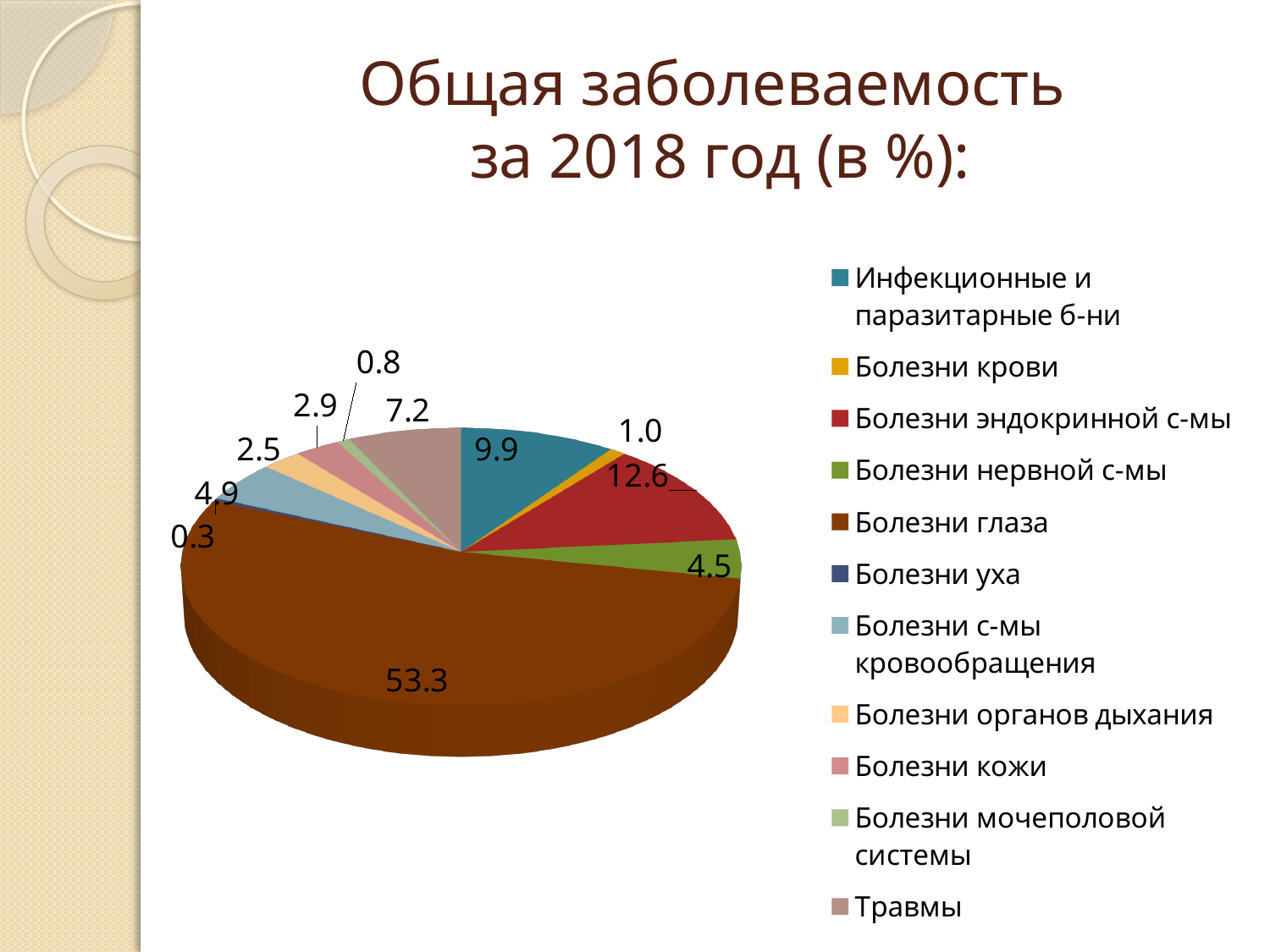
Which is larger, the value for Болезни кожи or the value for Болезни органов дыхания? Болезни кожи What is the value for Болезни глаза? 53.3 What is the value for Болезни эндокринной с-мы? 12.6 What kind of chart is shown on the slide? pie chart Which category has the largest share of the pie? Болезни глаза What is the title of the chart? Общая заболеваемость за 2018 год (в %): Which category has the smallest share of the pie? Болезни уха What is the difference between the values for Болезни эндокринной с-мы and Инфекционные и паразитарные б-ни? 2.7 What is the value for Травмы? 7.2 What is the value for Инфекционные и паразитарные б-ни? 9.9 How many categories does the legend list? 11 What is the value for Болезни уха? 0.3